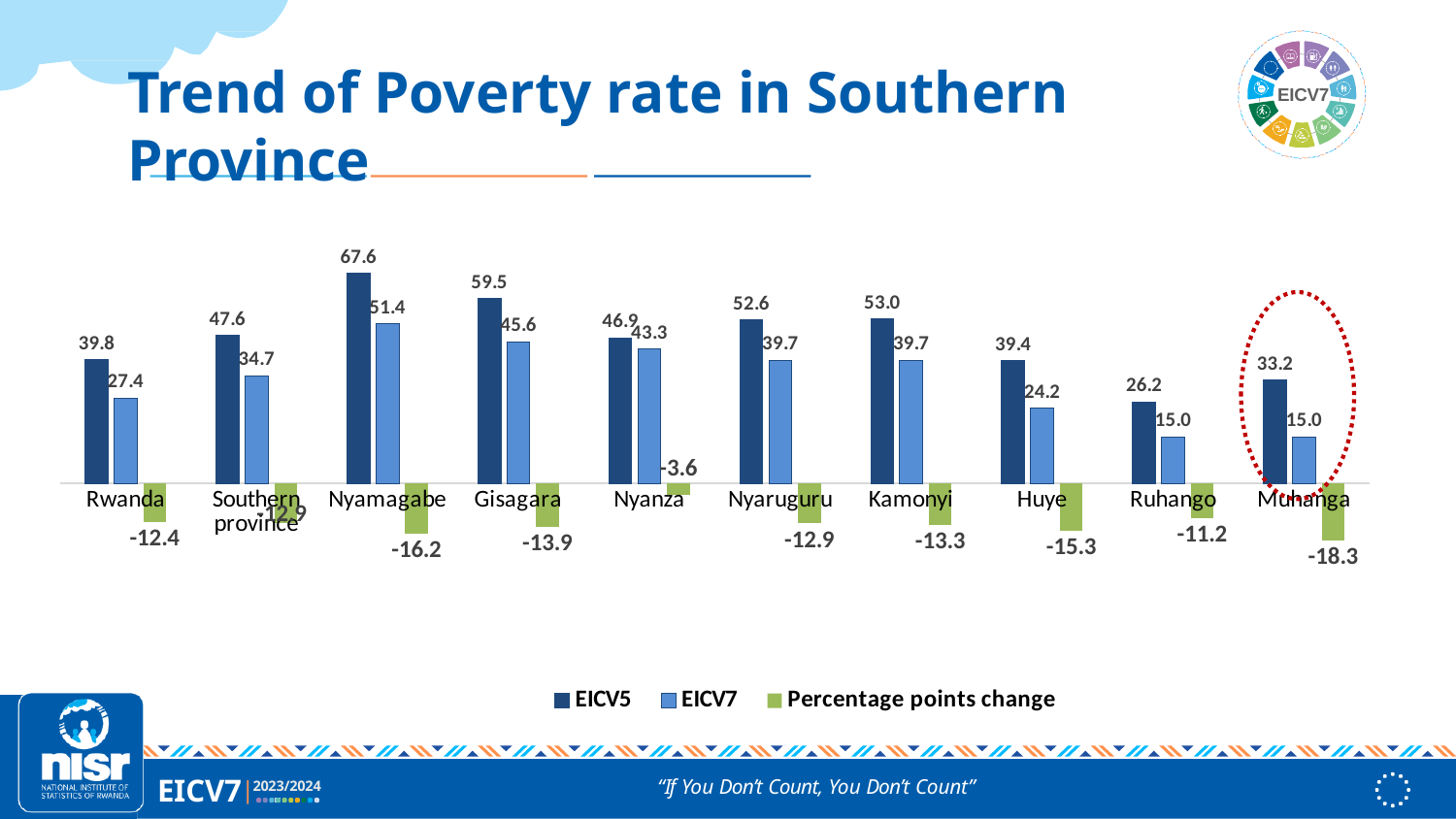
How many series does the legend list? 3 Which is larger, the EICV7 poverty rate for Nyanza or for Nyaruguru? Nyanza What is the percentage points change for Muhanga? -18.3 How many categories are shown on the x axis? 10 Which category has the highest EICV5 poverty rate? Nyamagabe What is the EICV5 poverty rate for Nyamagabe? 67.6 Which category has the lowest EICV5 poverty rate? Ruhango What is the EICV7 poverty rate for Huye? 24.2 What is the difference between the EICV5 and EICV7 poverty rates for Gisagara? 13.9 What kind of chart is shown on the slide? Bar chart Which category has the smallest percentage points change in absolute terms? Nyanza What is the EICV7 poverty rate for Rwanda? 27.4